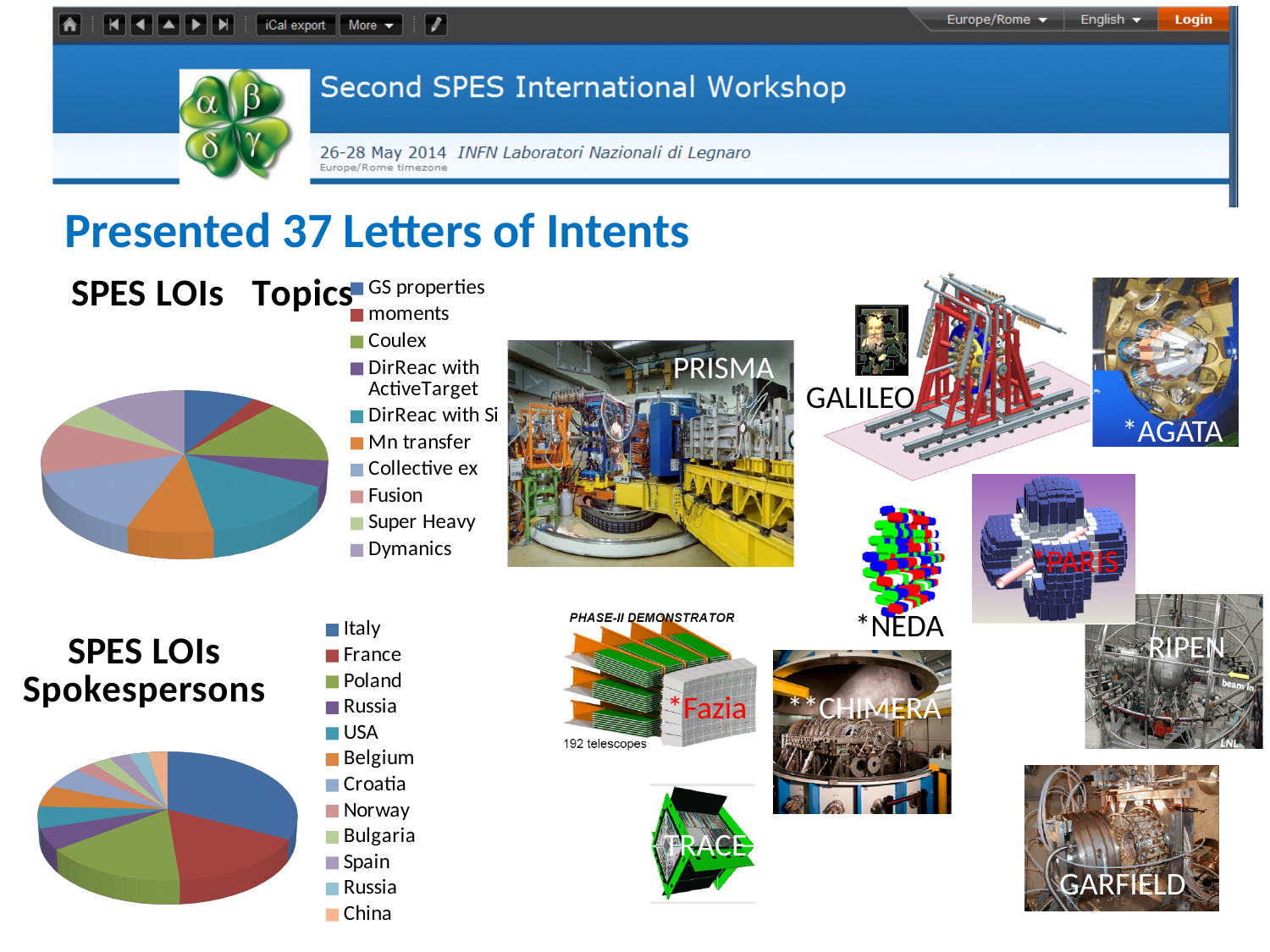
What is the title of the pie chart in the upper left of the slide? SPES LOIs Topics In the SPES LOIs Topics chart, which slice is larger, Coulex or moments? Coulex In the SPES LOIs Spokespersons chart, which slice is larger, Poland or China? Poland What kind of chart is the SPES LOIs Topics chart? pie chart In the SPES LOIs Spokespersons chart, which country has the largest slice? Italy In the SPES LOIs Spokespersons chart, which slice is larger, Italy or France? Italy How many categories does the legend of the SPES LOIs Topics chart list? 10 What kind of chart is the SPES LOIs Spokespersons chart? pie chart In the SPES LOIs Spokespersons chart, which country is shown in the first (blue) legend entry? Italy How many entries does the legend of the SPES LOIs Spokespersons chart list? 12